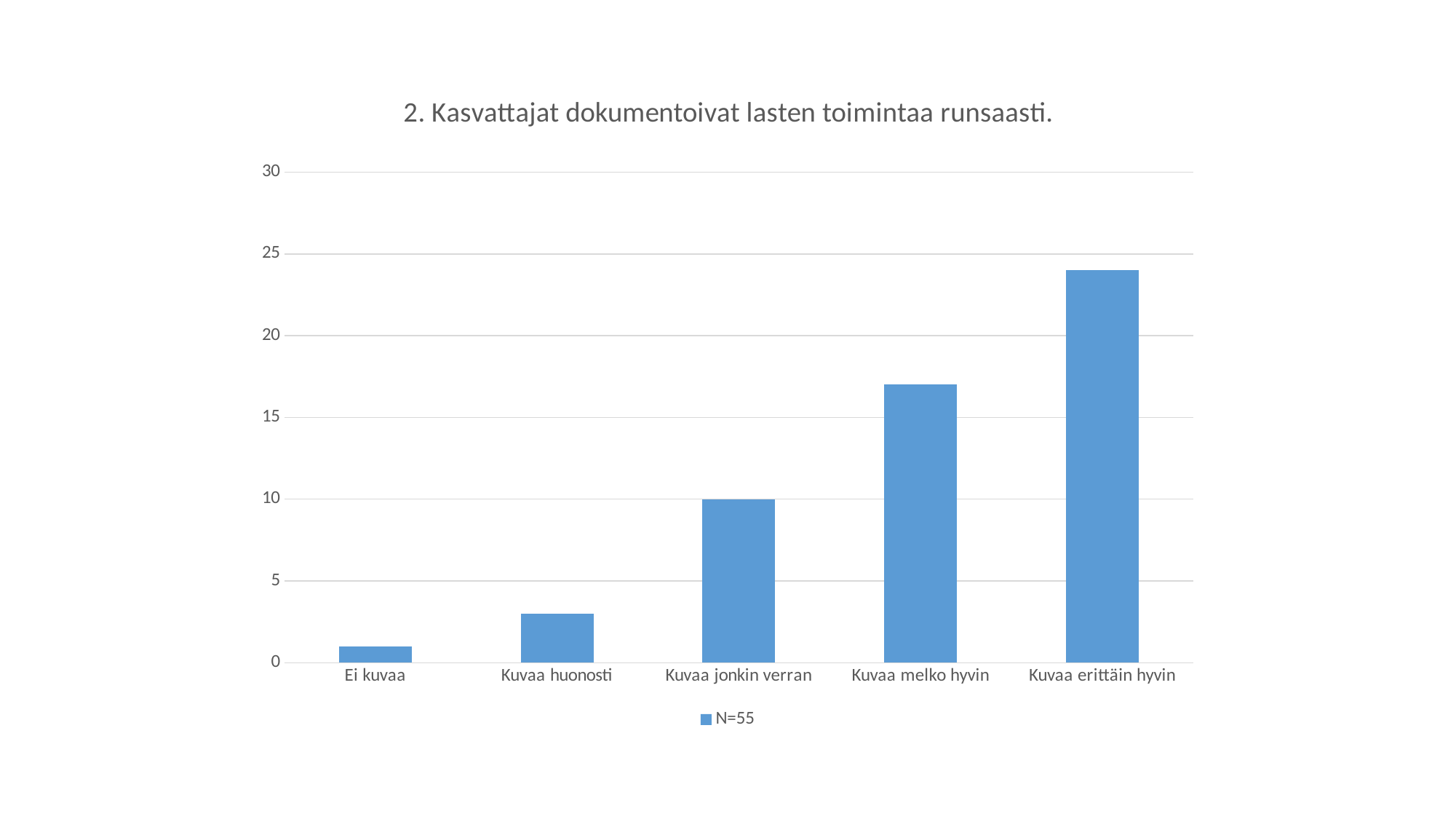
Is the value for Kuvaa huonosti greater or less than 5? less What kind of chart is shown on the slide? bar chart How many categories are shown on the x axis? 5 Which category has the lowest value? Ei kuvaa What is the value for Kuvaa jonkin verran? 10 Do the values rise or fall from left to right along the x axis? rise Is the value for Kuvaa melko hyvin greater or less than 15? greater Which category has the highest value? Kuvaa erittäin hyvin Is the value for Kuvaa erittäin hyvin greater or less than 20? greater What is the legend entry for the series? N=55 How many series does the legend list? 1 What is the title of the chart? 2. Kasvattajat dokumentoivat lasten toimintaa runsaasti.